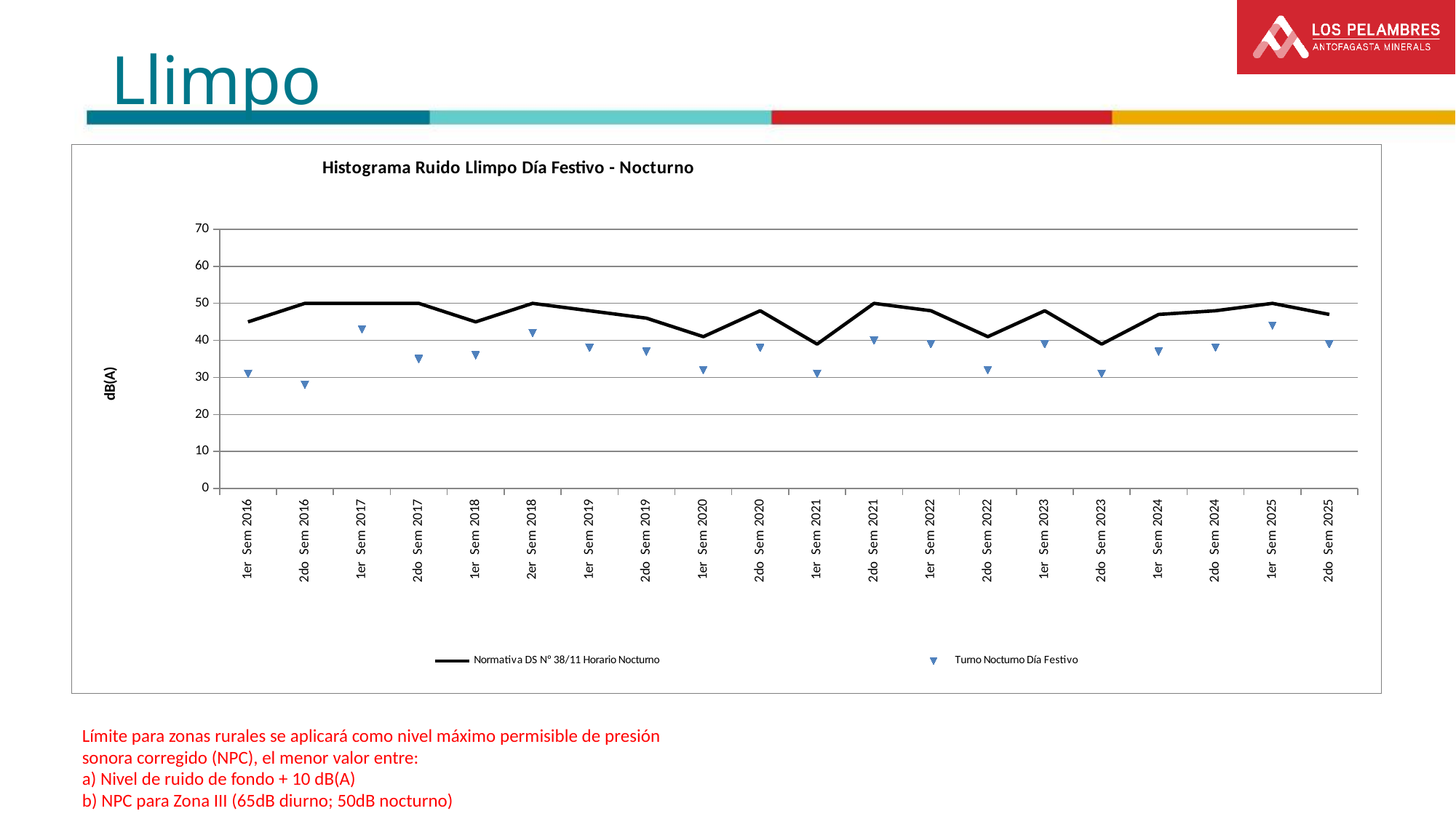
What is the title of the chart? Histograma Ruido Llimpo Día Festivo - Nocturno Which is larger at 2do Sem 2016: the Normativa DS N° 38/11 Horario Nocturno value or the Turno Nocturno Día Festivo value? Normativa DS N° 38/11 Horario Nocturno How many series does the chart legend list? 2 Is the Turno Nocturno Día Festivo value for 2do Sem 2017 greater or less than 40? less Is the Turno Nocturno Día Festivo value for 2do Sem 2016 greater or less than 30? less Is the Turno Nocturno Día Festivo value for 1er Sem 2017 greater or less than 40? greater How many semester categories are shown on the x axis? 20 Which is larger for Turno Nocturno Día Festivo: 1er Sem 2017 or 2do Sem 2017? 1er Sem 2017 Which semester has the lowest value for Turno Nocturno Día Festivo? 2do Sem 2016 What kind of chart is shown on the slide? line chart What is the label of the vertical axis? dB(A)